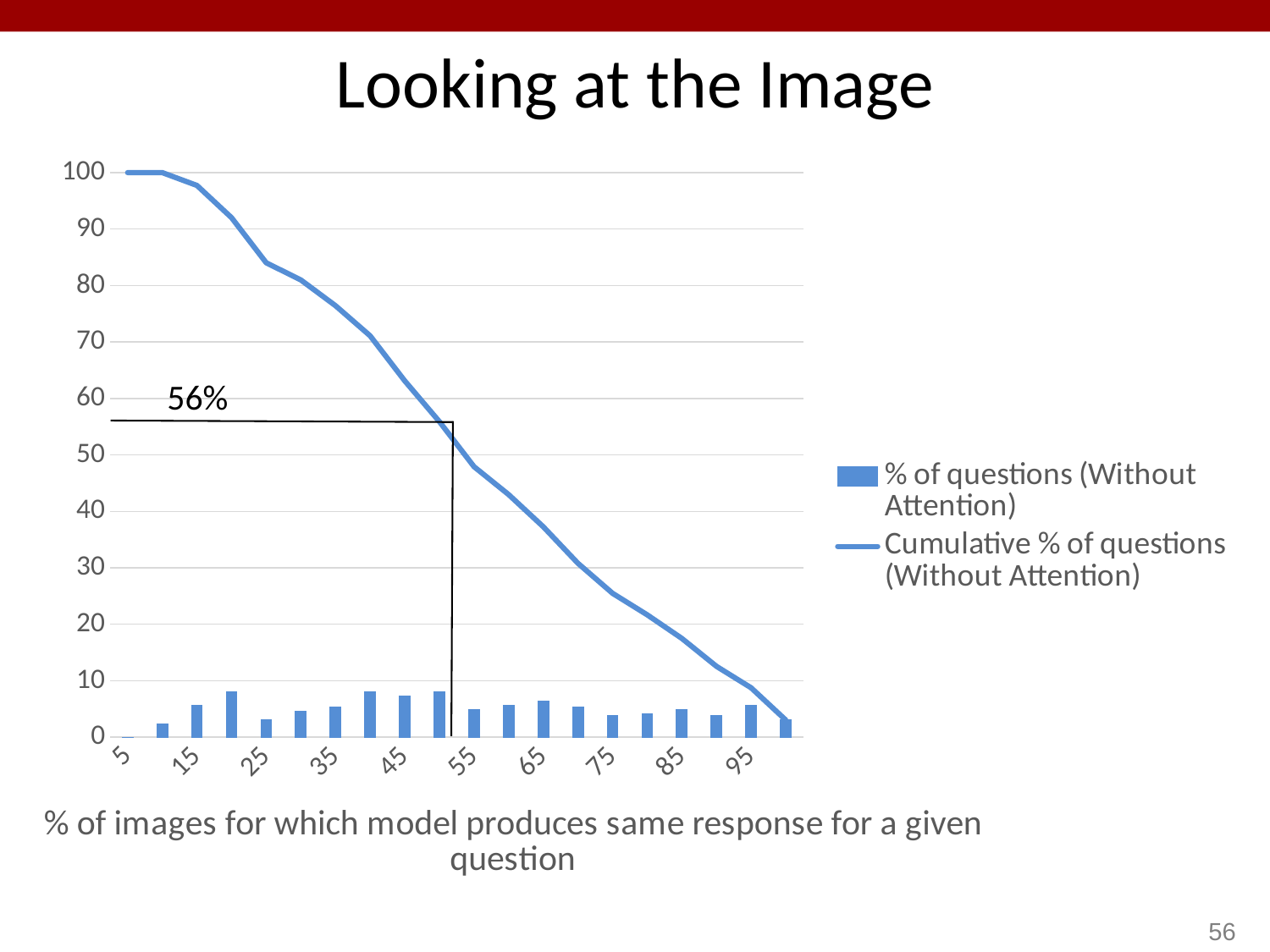
How many series does the chart legend list? 2 Does the cumulative % of questions line rise or fall as the x-axis value increases? Falls Is the % of questions (Without Attention) bar at x = 25 greater or less than 5? less Which series is drawn as a line in the chart? Cumulative % of questions (Without Attention) Is the cumulative % of questions larger at x = 25 or at x = 75? x = 25 Is the cumulative % of questions at x = 25 greater or less than 80? greater What cumulative percentage is marked by the annotation on the chart? 56% What is the value of the cumulative % of questions line at x = 5? 100 Is the cumulative % of questions at x = 55 greater or less than 50? less What is the title of the chart on this slide? Looking at the Image What kind of chart is shown on the slide? A combined bar and line chart